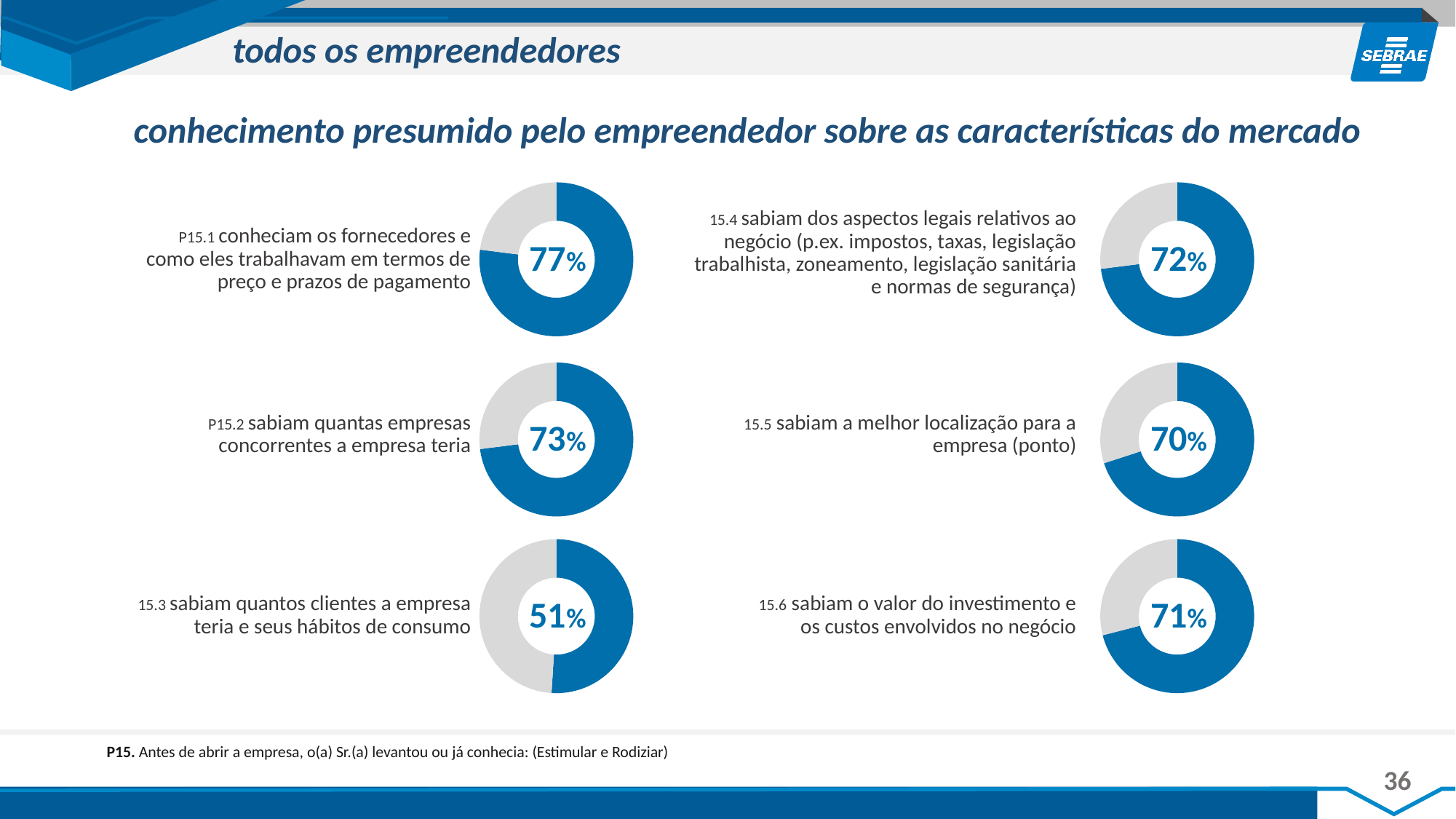
Which is larger: the percentage for P15.2 (sabiam quantas empresas concorrentes) or for 15.5 (sabiam a melhor localização)? P15.2 (73%) What is the difference in percentage points between the P15.1 chart (77%) and the 15.3 chart (51%)? 26 percentage points Which of the six items on the slide has the highest percentage? P15.1 conheciam os fornecedores e como eles trabalhavam em termos de preço e prazos de pagamento (77%) What percentage is shown in the donut chart for P15.1 (conheciam os fornecedores e como eles trabalhavam em termos de preço e prazos de pagamento)? 77% What percentage is shown in the donut chart for P15.2 (sabiam quantas empresas concorrentes a empresa teria)? 73% What percentage is shown in the donut chart for 15.5 (sabiam a melhor localização para a empresa)? 70% What percentage is shown in the donut chart for 15.3 (sabiam quantos clientes a empresa teria e seus hábitos de consumo)? 51% What percentage is shown in the donut chart for 15.4 (sabiam dos aspectos legais relativos ao negócio)? 72% What percentage is shown in the donut chart for 15.6 (sabiam o valor do investimento e os custos envolvidos no negócio)? 71% What type of chart is used to display each percentage on the slide? Donut (pie) chart Which of the six items on the slide has the lowest percentage? 15.3 sabiam quantos clientes a empresa teria e seus hábitos de consumo (51%) How many donut charts are shown on the slide? 6